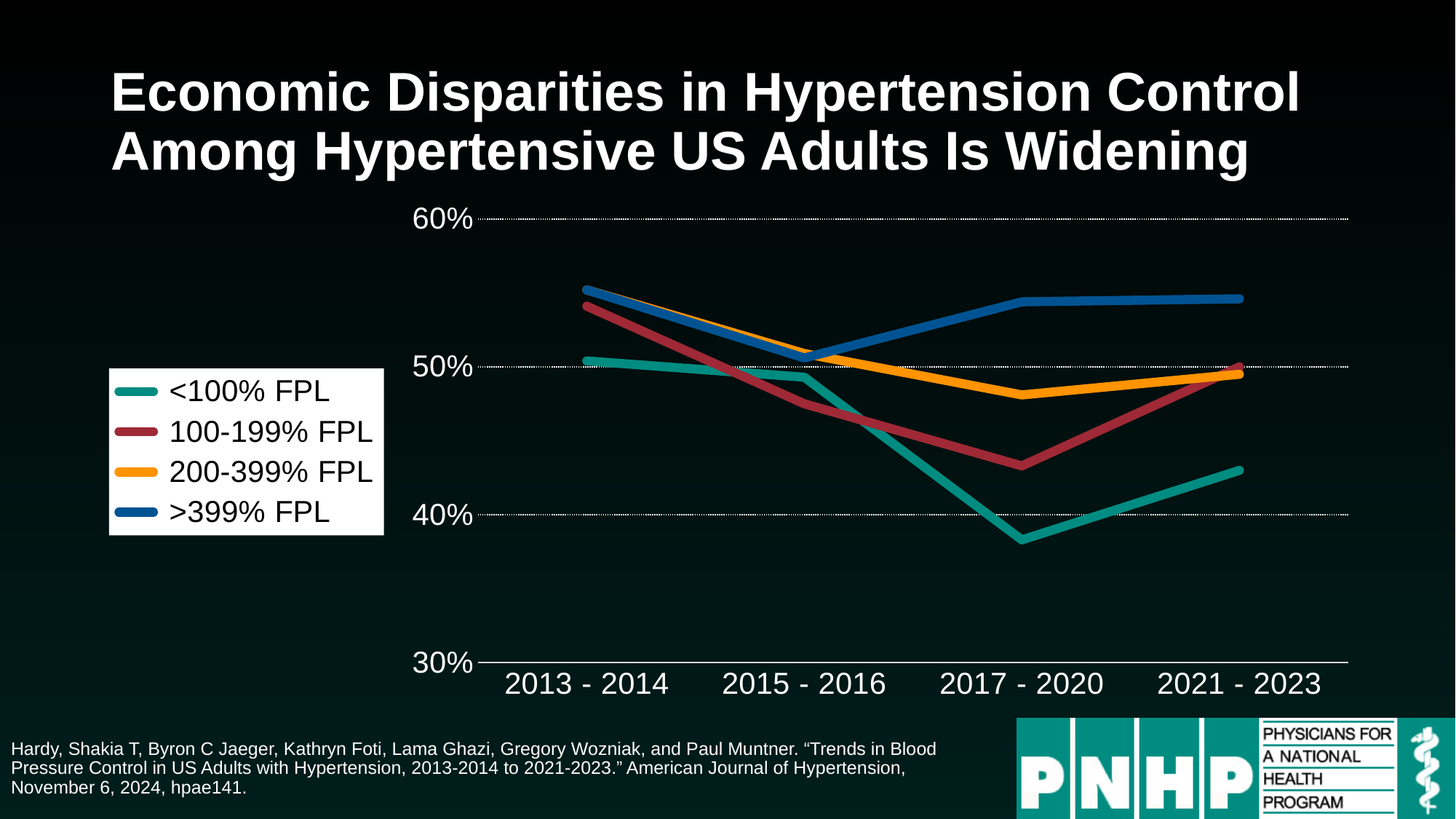
Is the value for 200-399% FPL in 2013 - 2014 greater or less than 50%? greater Is the value for >399% FPL in 2017 - 2020 greater or less than 50%? greater How many time periods are shown on the x axis? 4 Is the value for <100% FPL in 2021 - 2023 greater or less than 40%? greater What kind of chart is shown on the slide? line chart Does the value for <100% FPL rise or fall from 2013 - 2014 to 2017 - 2020? fall Which series has the highest value in 2021 - 2023? >399% FPL Which series has the lowest value in 2017 - 2020? <100% FPL In 2017 - 2020, which is larger: the value for 100-199% FPL or the value for <100% FPL? 100-199% FPL How many series does the legend list? 4